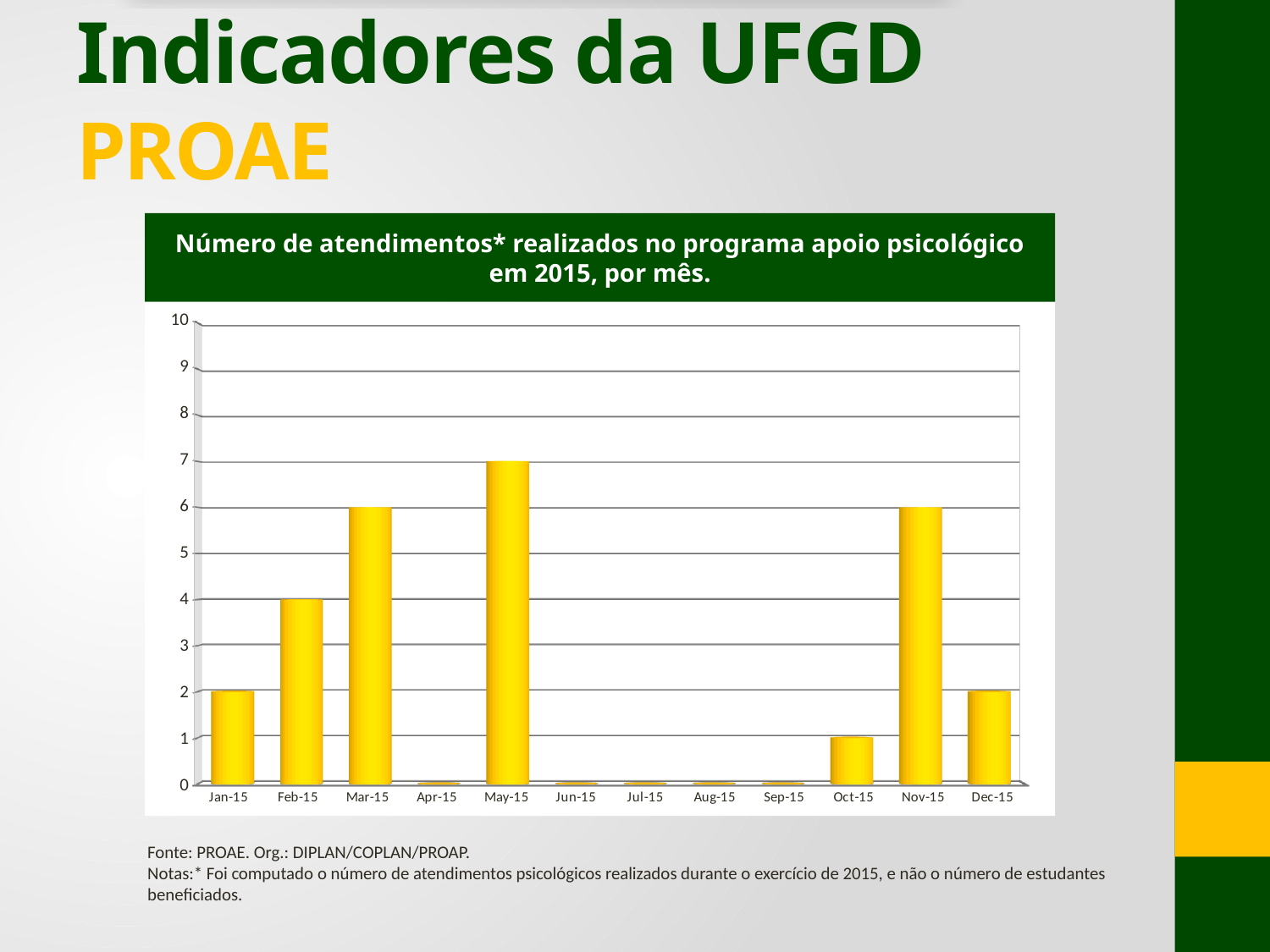
How many months are shown on the x axis of the chart? 12 What is the value for Mar-15? 6 Which month has the highest number of atendimentos? May-15 Is the value for Nov-15 greater or less than 5? greater What type of chart is shown on the slide? bar chart What is the value for Feb-15? 4 What is the difference between the values for May-15 and Mar-15? 1 What is the value for Oct-15? 1 What is the title of the chart? Número de atendimentos* realizados no programa apoio psicológico em 2015, por mês. Which is larger, the value for Feb-15 or the value for Dec-15? Feb-15 What is the value for May-15? 7 What is the value for Jan-15? 2